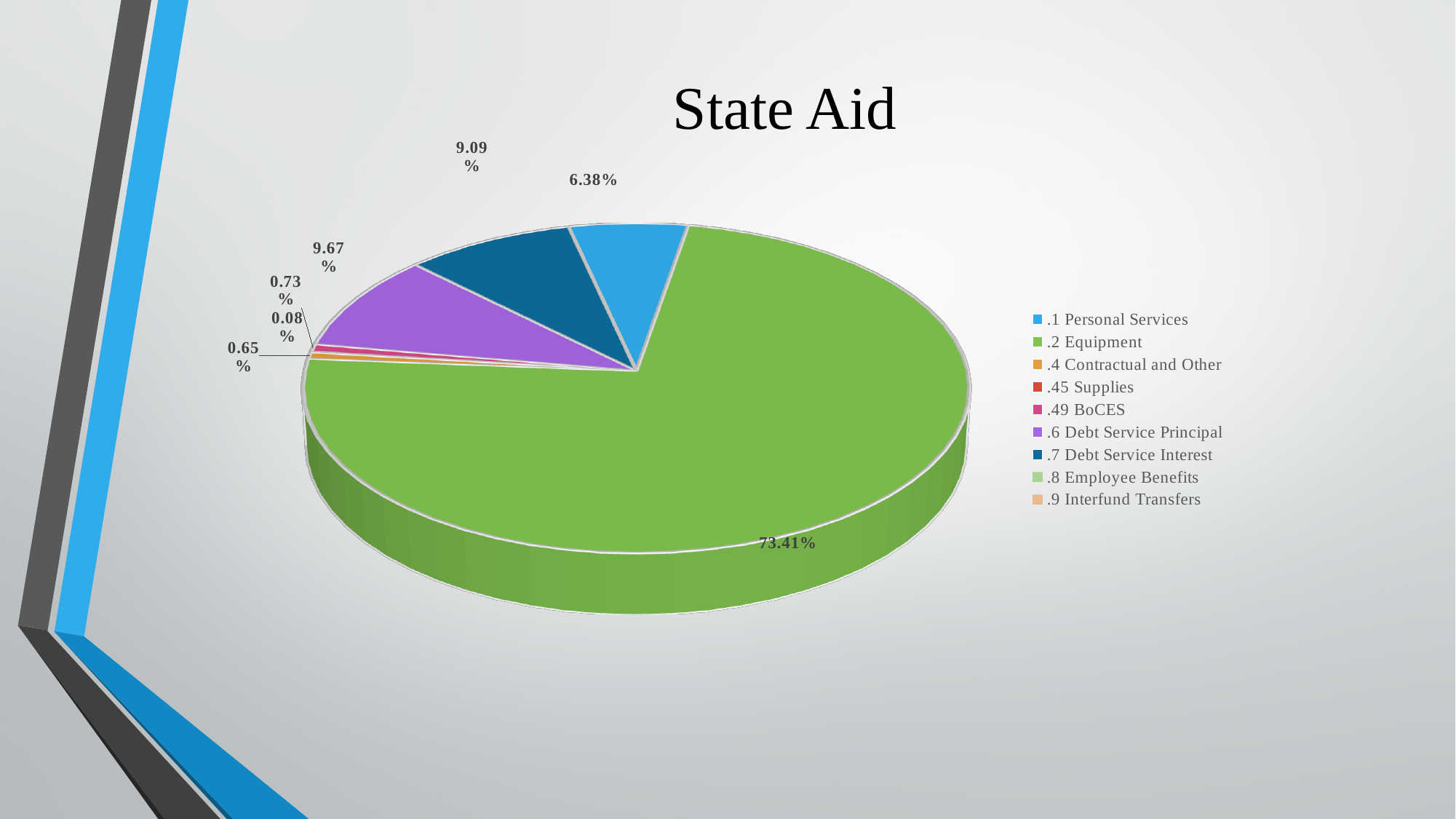
What type of chart is shown on the slide? pie chart What colour is the .2 Equipment slice? green What percentage of State Aid is .1 Personal Services? 6.38% What is the title of the chart? State Aid What percentage of State Aid is .2 Equipment? 73.41% Which category has the largest share of the pie? .2 Equipment What is the difference in percentage points between .2 Equipment and .1 Personal Services? 67.03 How many categories does the legend list? 9 Which is larger, the share for .6 Debt Service Principal or .7 Debt Service Interest? .6 Debt Service Principal What percentage of State Aid is .6 Debt Service Principal? 9.67% What is the difference in percentage points between .6 Debt Service Principal and .7 Debt Service Interest? 0.58 What percentage of State Aid is .7 Debt Service Interest? 9.09%